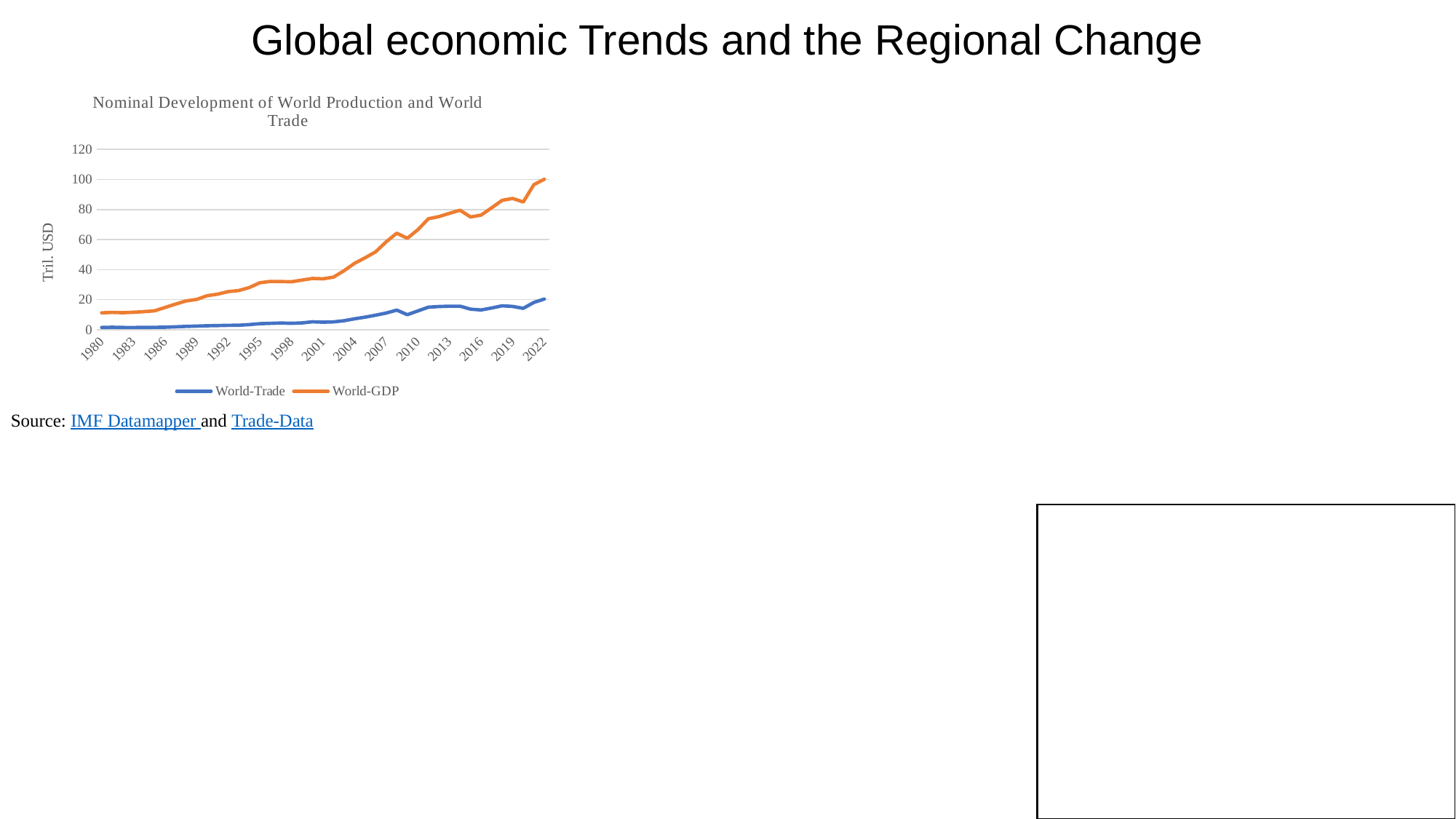
What is the title of the chart? Nominal Development of World Production and World Trade Is the value for World-GDP in 2007 greater or less than 40? greater Is the value for World-GDP in 2019 greater or less than 80? greater How many year labels are shown on the x axis? 15 Is the value for World-Trade in 2013 greater or less than 20? less How many series does the legend list? 2 Does the World-Trade line generally rise or fall from 1980 to 2022? Rise What is the label on the vertical axis of the chart? Tril. USD Which series is higher in 2022, World-Trade or World-GDP? World-GDP Does the World-GDP line generally rise or fall from 1980 to 2022? Rise What kind of chart is shown on the slide? Line chart